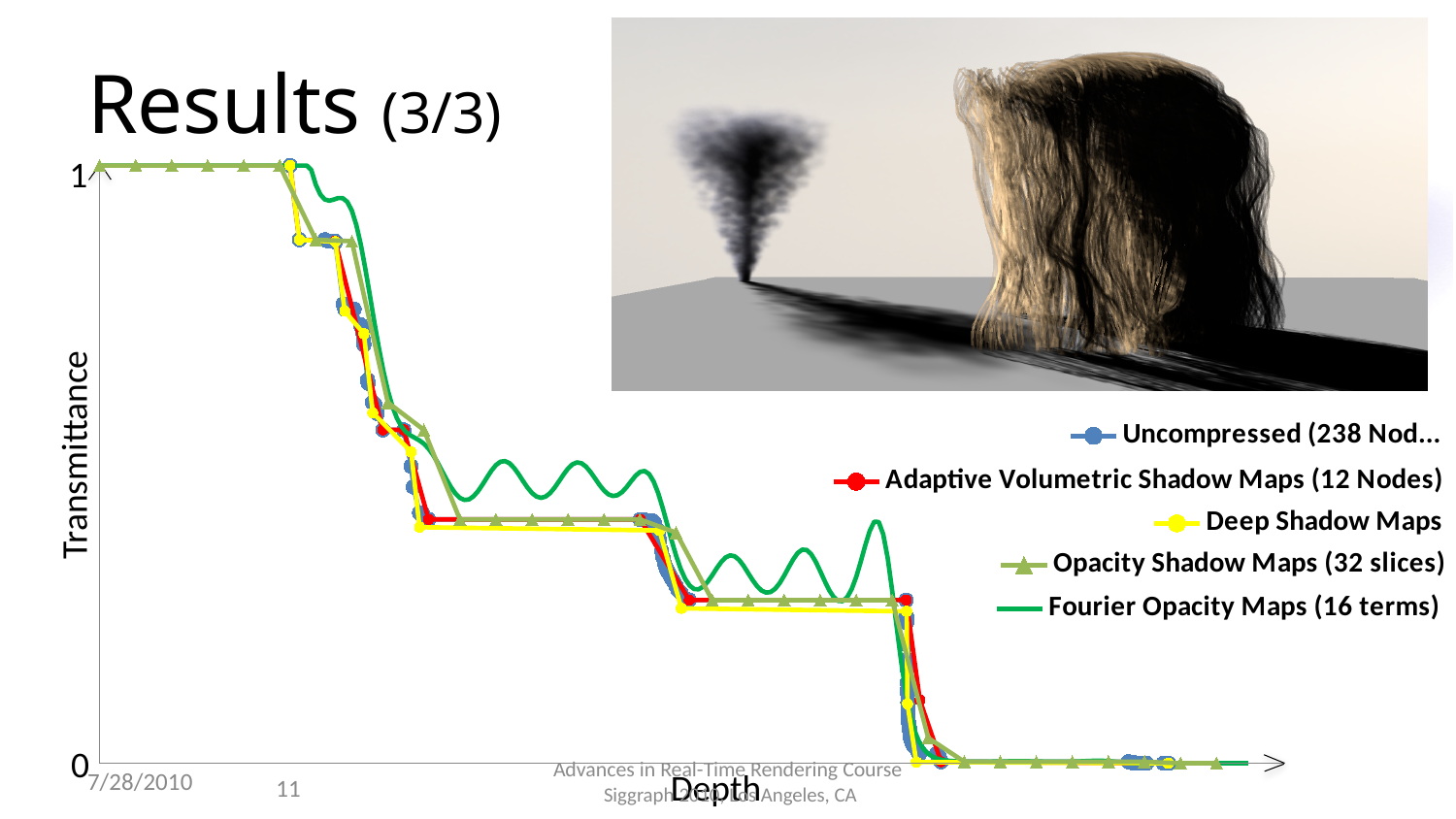
What transmittance value do all the series start at on the left of the chart? 1 What is the label of the chart's horizontal axis? Depth How many nodes does the legend give for Adaptive Volumetric Shadow Maps? 12 Nodes How many series does the chart's legend list? 5 What is the highest value shown on the Transmittance axis? 1 What is the label of the chart's vertical axis? Transmittance How many terms does the legend give for Fourier Opacity Maps? 16 terms How many slices does the legend give for Opacity Shadow Maps? 32 slices Do the transmittance values rise or fall as depth increases? fall What kind of chart is shown on the slide? line chart What is the lowest value shown on the Transmittance axis? 0